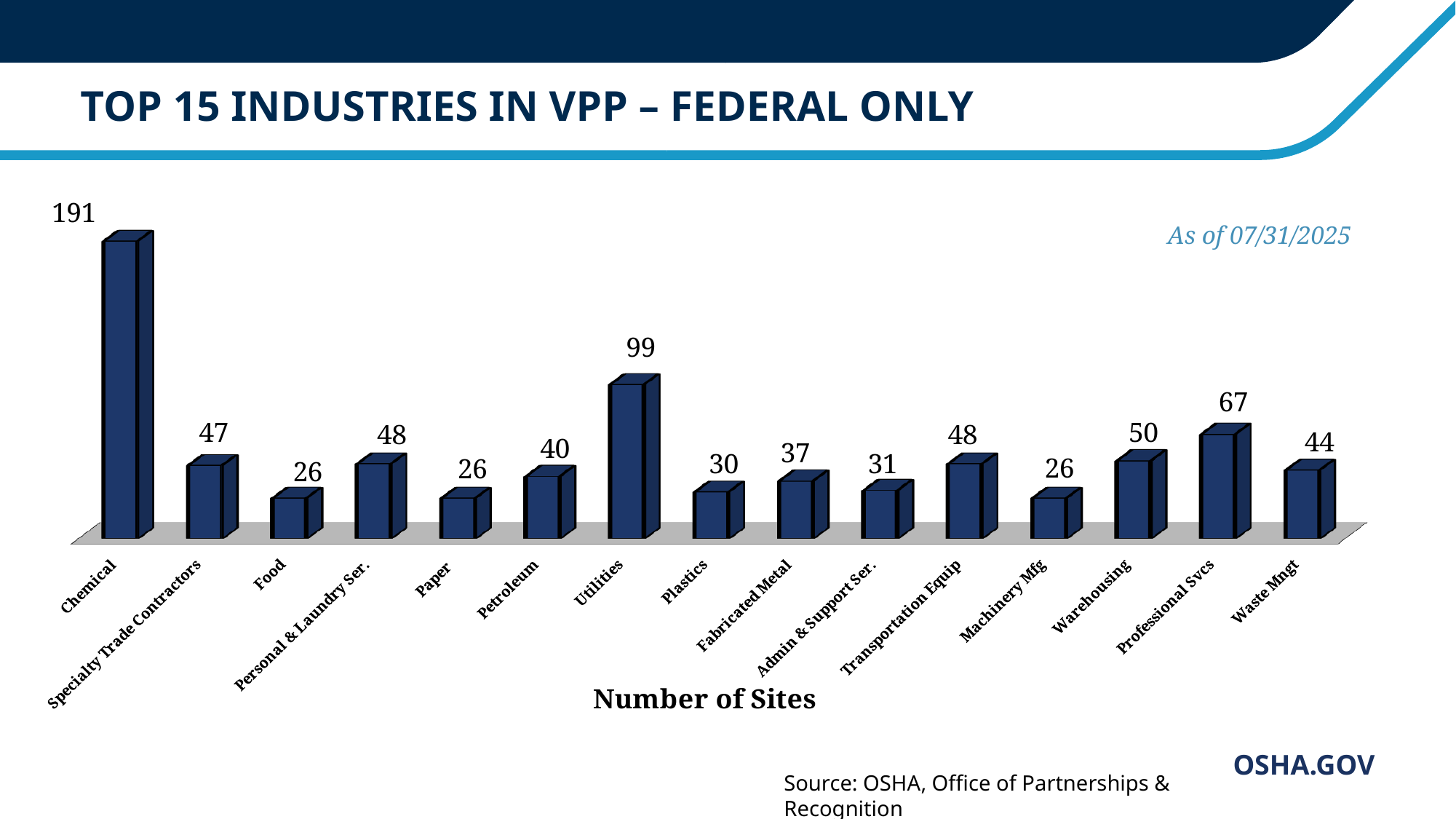
What is the difference in number of sites between Chemical and Utilities? 92 Which has more sites, Waste Mngt or Plastics? Waste Mngt What is the difference in number of sites between Professional Svcs and Warehousing? 17 What kind of chart is shown on the slide? Bar chart How many industries are shown in the chart? 15 What is the x-axis title of the chart? Number of Sites What is the number of sites for Utilities? 99 Which industry has the highest number of sites? Chemical Which has more sites, Petroleum or Fabricated Metal? Petroleum What is the number of sites for Admin & Support Ser.? 31 What is the number of sites for Chemical? 191 What is the number of sites for Professional Svcs? 67